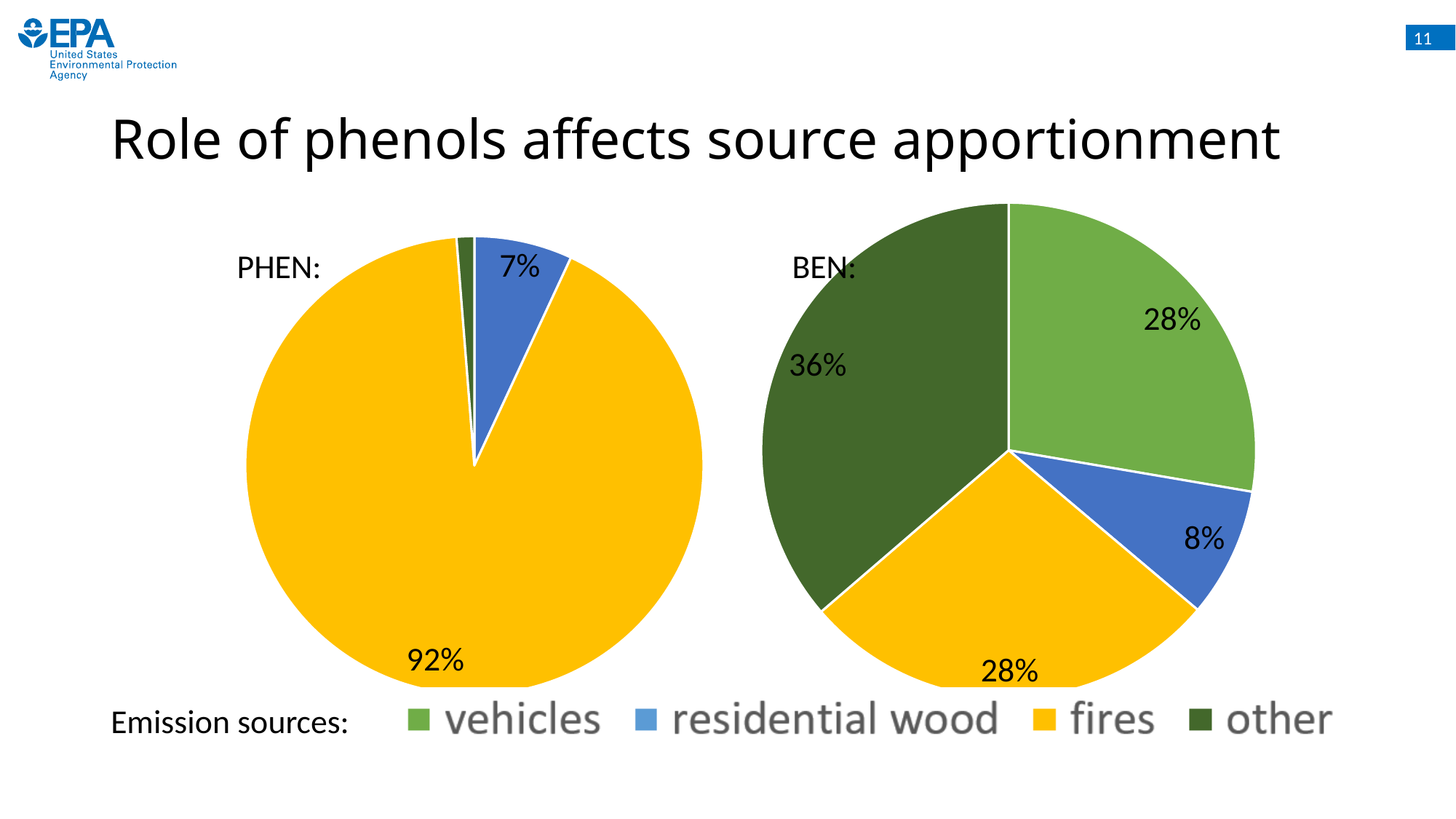
In the BEN pie chart, which emission source has the largest share? other In the BEN pie chart, what share is attributed to vehicles? 28% In the BEN pie chart, what share is attributed to residential wood? 8% In the PHEN pie chart, which emission source has the largest share? fires Is the share for fires larger in the PHEN pie chart or the BEN pie chart? PHEN What kind of charts are shown on the slide? Pie charts In the BEN pie chart, which emission source has the smallest share? residential wood In the BEN pie chart, how many percentage points larger is the share for other than the share for vehicles? 8 percentage points How many emission sources does the legend list? 4 In the BEN pie chart, what share is attributed to other? 36% In the PHEN pie chart, what share is attributed to fires? 92% In the PHEN pie chart, what share is attributed to residential wood? 7%